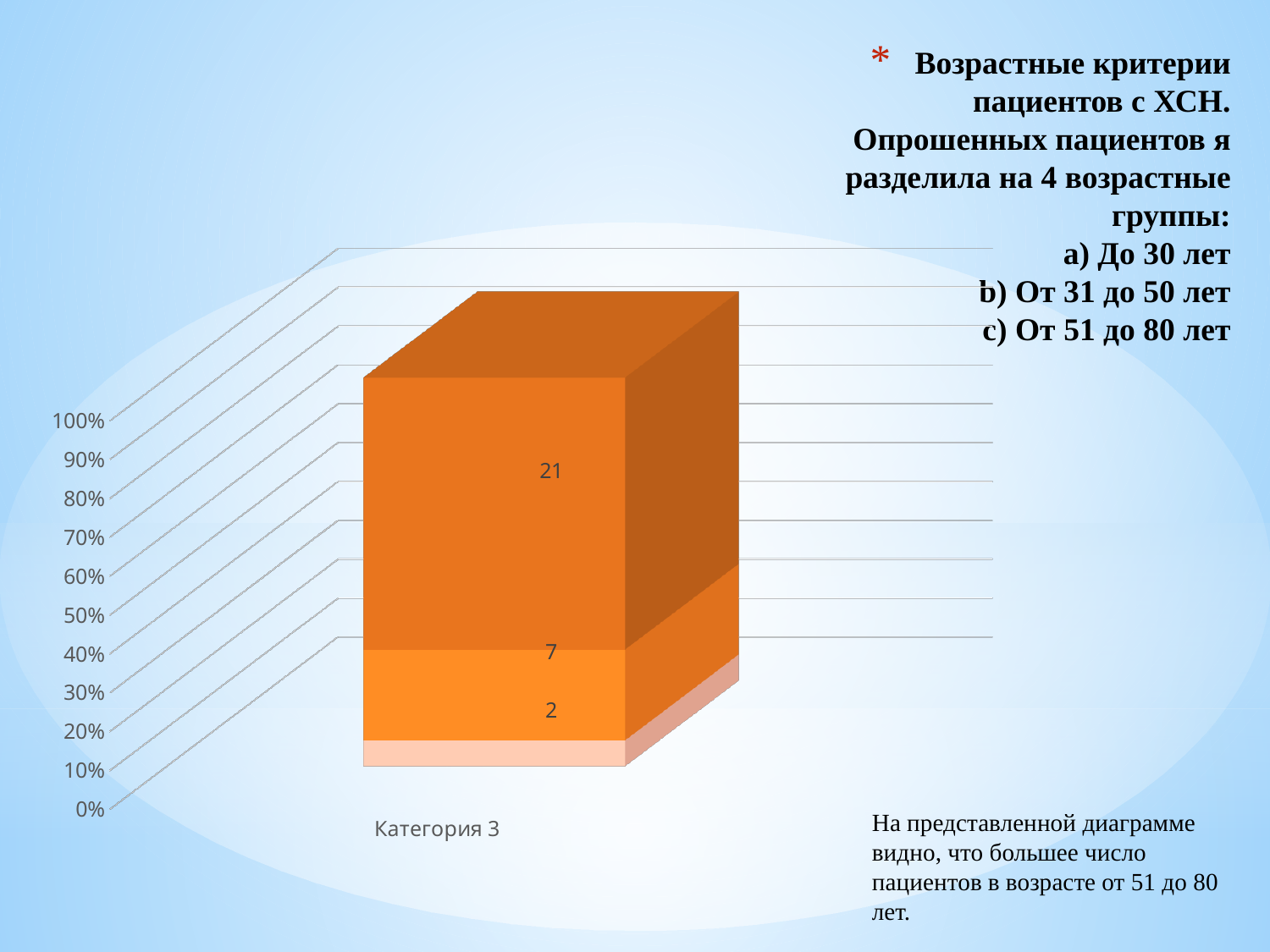
What is the value of the top (largest, dark orange) segment of the bar? 21 What share of the bar's total does the top segment (21) represent? 70% Which segment of the bar has the smallest value? The bottom segment (2) What is the value of the middle segment of the bar? 7 What is the label of the category on the x axis? Категория 3 What is the value of the bottom (light peach) segment of the bar? 2 Which segment of the bar has the largest value? The top segment (21) What is the difference between the top segment value and the middle segment value? 14 How many segments make up the stacked bar for Категория 3? 3 How many categories are shown on the x axis of the chart? 1 What kind of chart is shown on the slide? Stacked bar chart What is the total of all segments in the stacked bar for Категория 3? 30